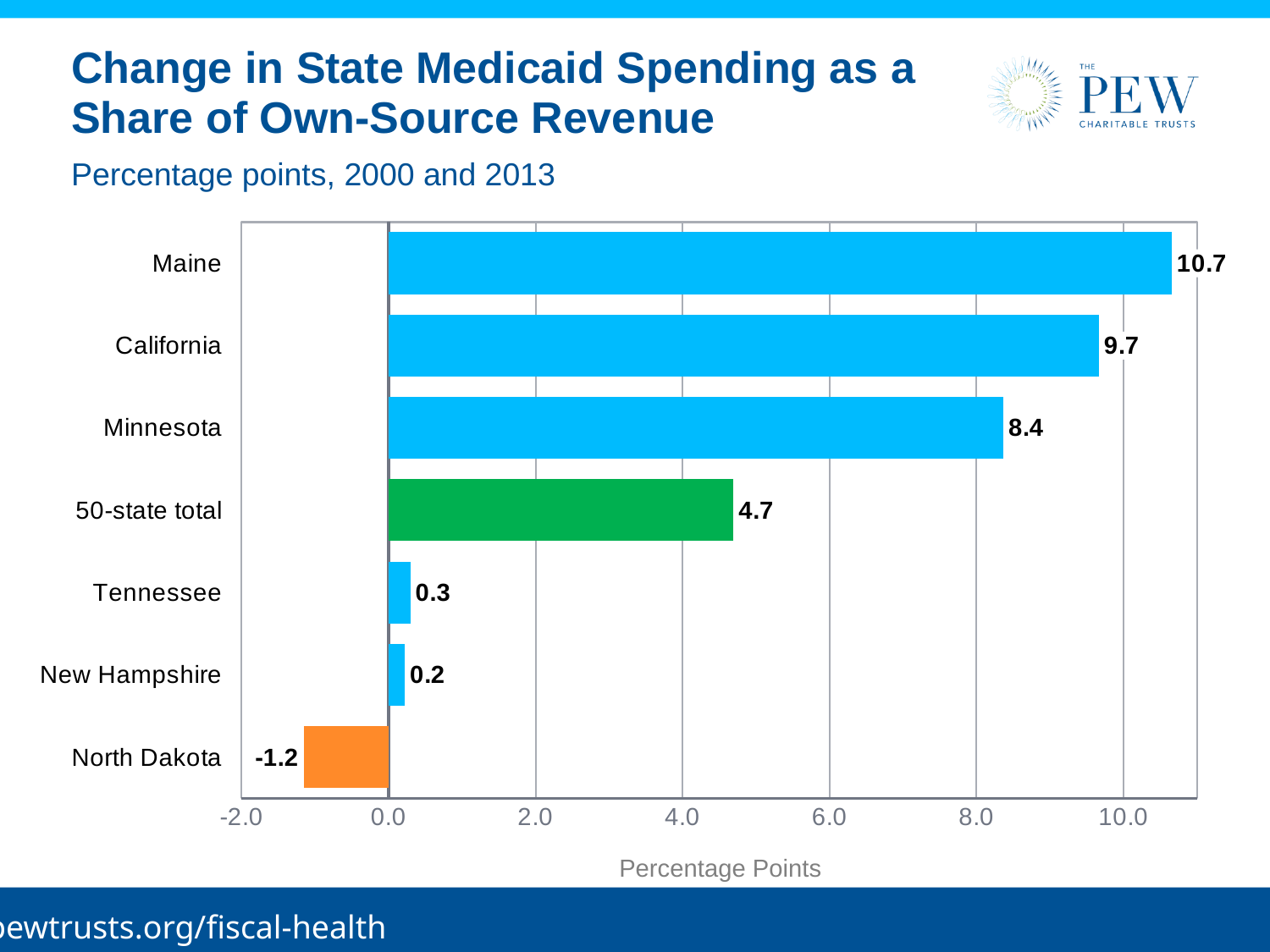
What is the value for Maine? 10.7 Which is larger, the value for Tennessee or the value for New Hampshire? Tennessee What is the value for North Dakota? -1.2 What kind of chart is this? bar chart How many categories are shown in the chart? 7 Which category has the lowest value? North Dakota Is the value for Minnesota greater or less than 8.0? greater What is the value for the 50-state total? 4.7 Which category has the highest value? Maine What is the difference between the values for Minnesota and the 50-state total? 3.7 What is the label on the horizontal axis? Percentage Points What is the difference between the values for Maine and California? 1.0